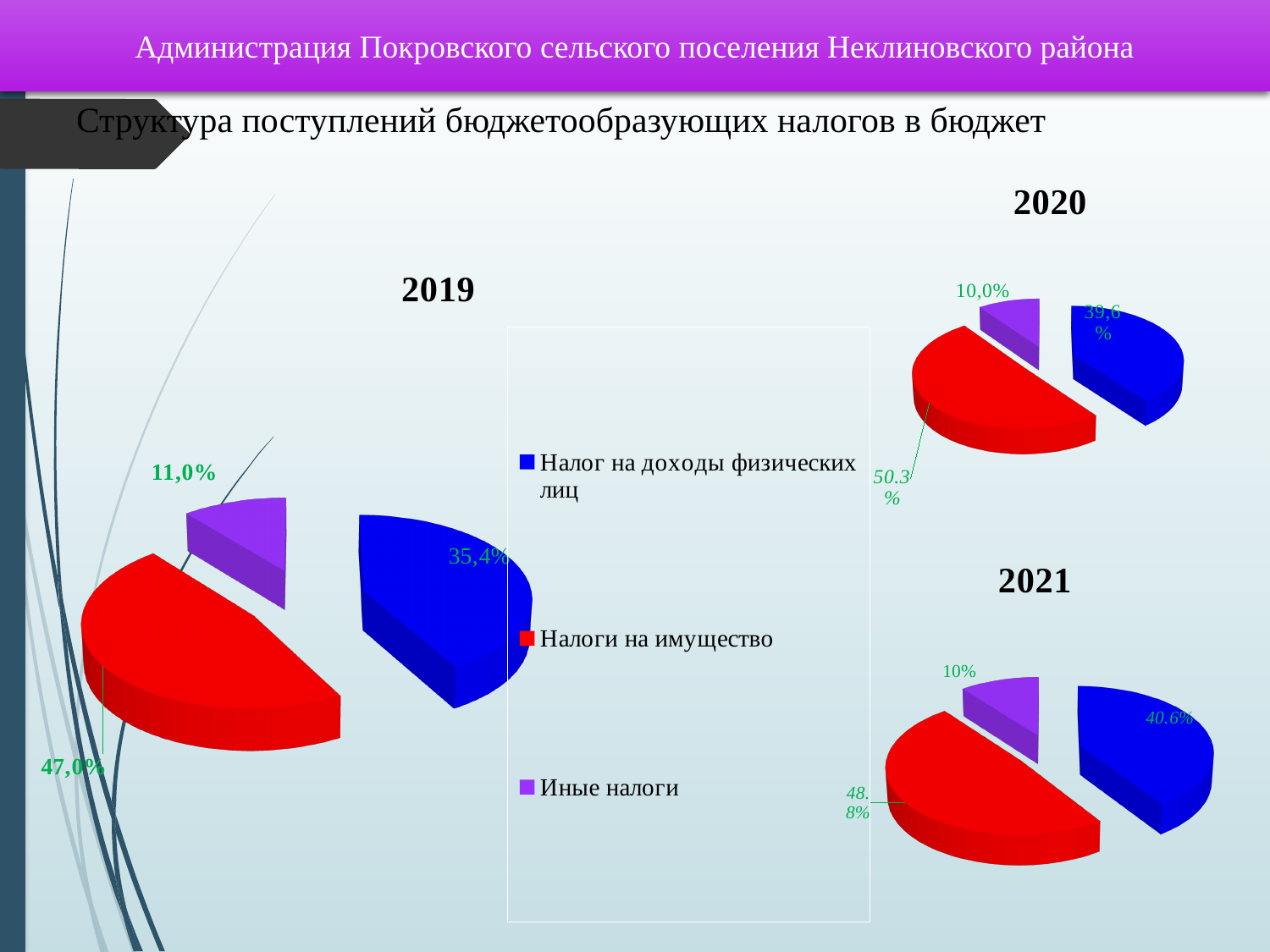
In the 2021 pie chart, what share is shown for Налоги на имущество? 48.8% How many series does the legend list? 3 In the 2020 pie chart, which category has the largest slice? Налоги на имущество In the 2021 pie chart, which category has the smallest slice? Иные налоги In the 2020 pie chart, what share is shown for Налоги на имущество? 50.3% Which colour represents Иные налоги in the pie charts? Purple In the 2019 pie chart, what share is shown for Налоги на имущество? 47,0% In the 2020 pie chart, what share is shown for Налог на доходы физических лиц? 39,6% In the 2019 pie chart, what share is shown for Иные налоги? 11,0% In the 2019 pie chart, what share is shown for Налог на доходы физических лиц? 35,4% What type of charts are shown on the slide? Pie charts In the 2021 pie chart, what share is shown for Налог на доходы физических лиц? 40.6%